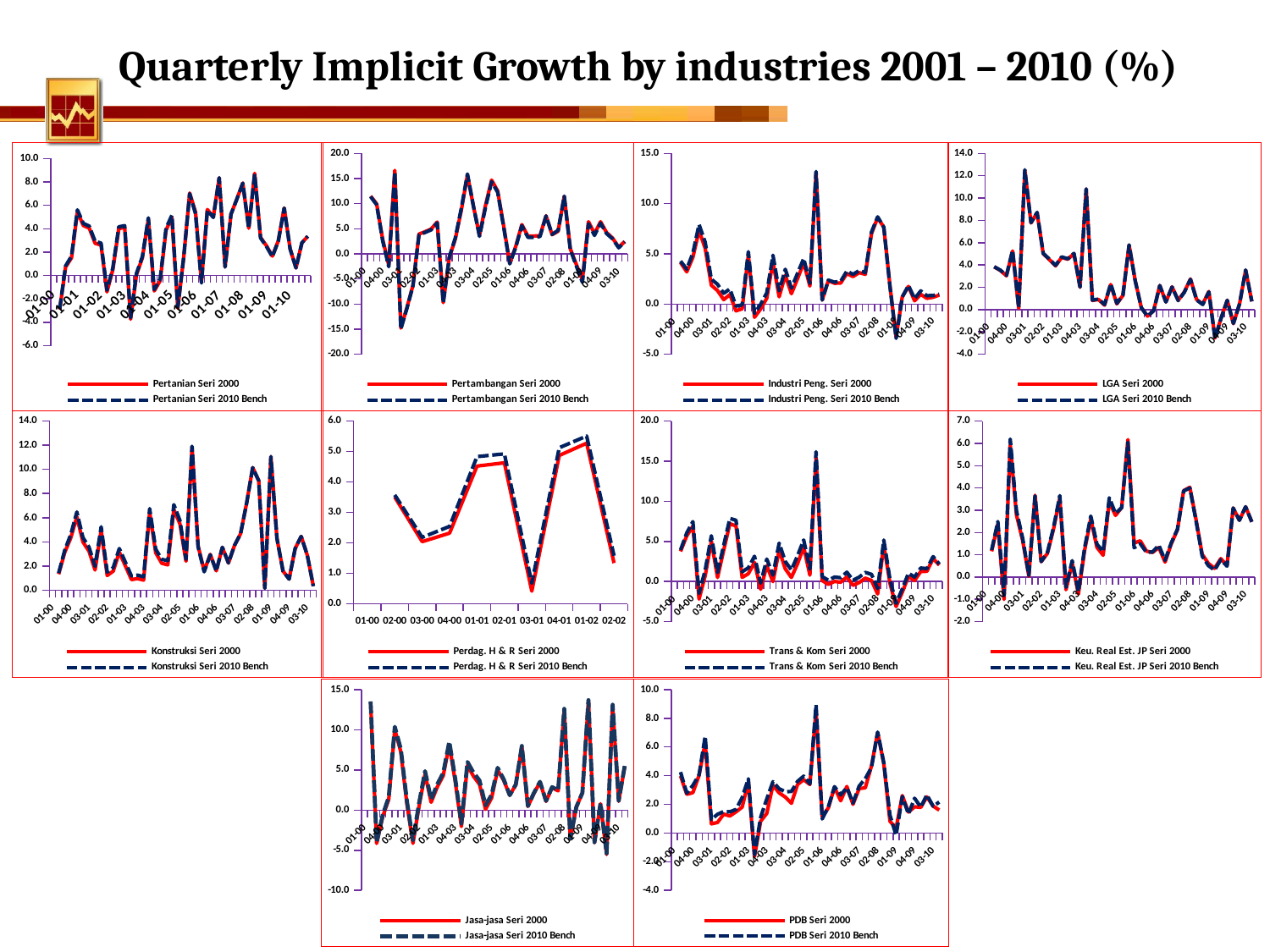
How many charts are shown on the slide? 10 What kind of chart is the Pertanian chart in the top-left? Line chart On the Perdag. H & R chart, how many quarters are shown on the x axis? 10 On the Perdag. H & R chart, is the Seri 2000 value at 03-01 greater or less than 1.0? less On the Pertambangan chart, is the lowest point of the lines greater or less than -10.0? less On the Perdag. H & R chart, does the Seri 2000 line rise or fall from 01-00 to 03-00? fall On the Industri Peng. chart, is the highest peak of the lines greater or less than 10.0? greater How many series does the legend of the Pertambangan chart list? 2 What are the two legend entries on the PDB chart at the bottom? PDB Seri 2000 and PDB Seri 2010 Bench On the Konstruksi chart, which line style is used for the Seri 2010 Bench series? Dashed dark blue line